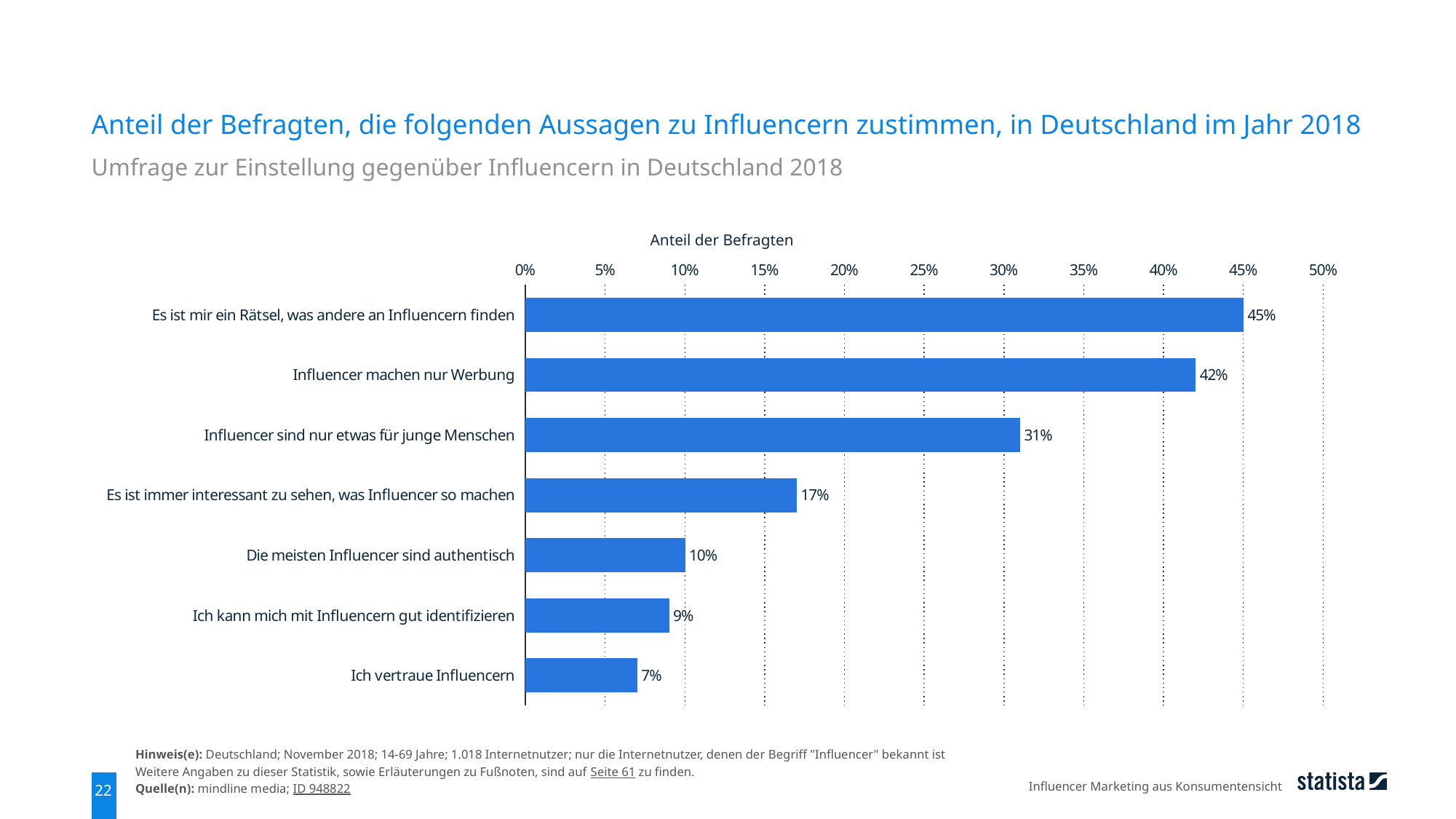
What share of respondents agree with the statement "Influencer machen nur Werbung"? 42% What is the difference between the two highest values in the chart? 3 percentage points Which statement has the highest share of agreement? Es ist mir ein Rätsel, was andere an Influencern finden Is the value for "Influencer sind nur etwas für junge Menschen" greater or less than 25%? greater Which is larger: the share for "Ich kann mich mit Influencern gut identifizieren" or for "Die meisten Influencer sind authentisch"? Die meisten Influencer sind authentisch Which statement has the lowest share of agreement? Ich vertraue Influencern What kind of chart is shown on the slide? Bar chart How many statements are shown in the chart? 7 What share of respondents agree with "Ich vertraue Influencern"? 7% What is the value for "Es ist immer interessant zu sehen, was Influencer so machen"? 17% What is the difference between the shares for "Influencer sind nur etwas für junge Menschen" and "Die meisten Influencer sind authentisch"? 21 percentage points What is the label of the value axis? Anteil der Befragten